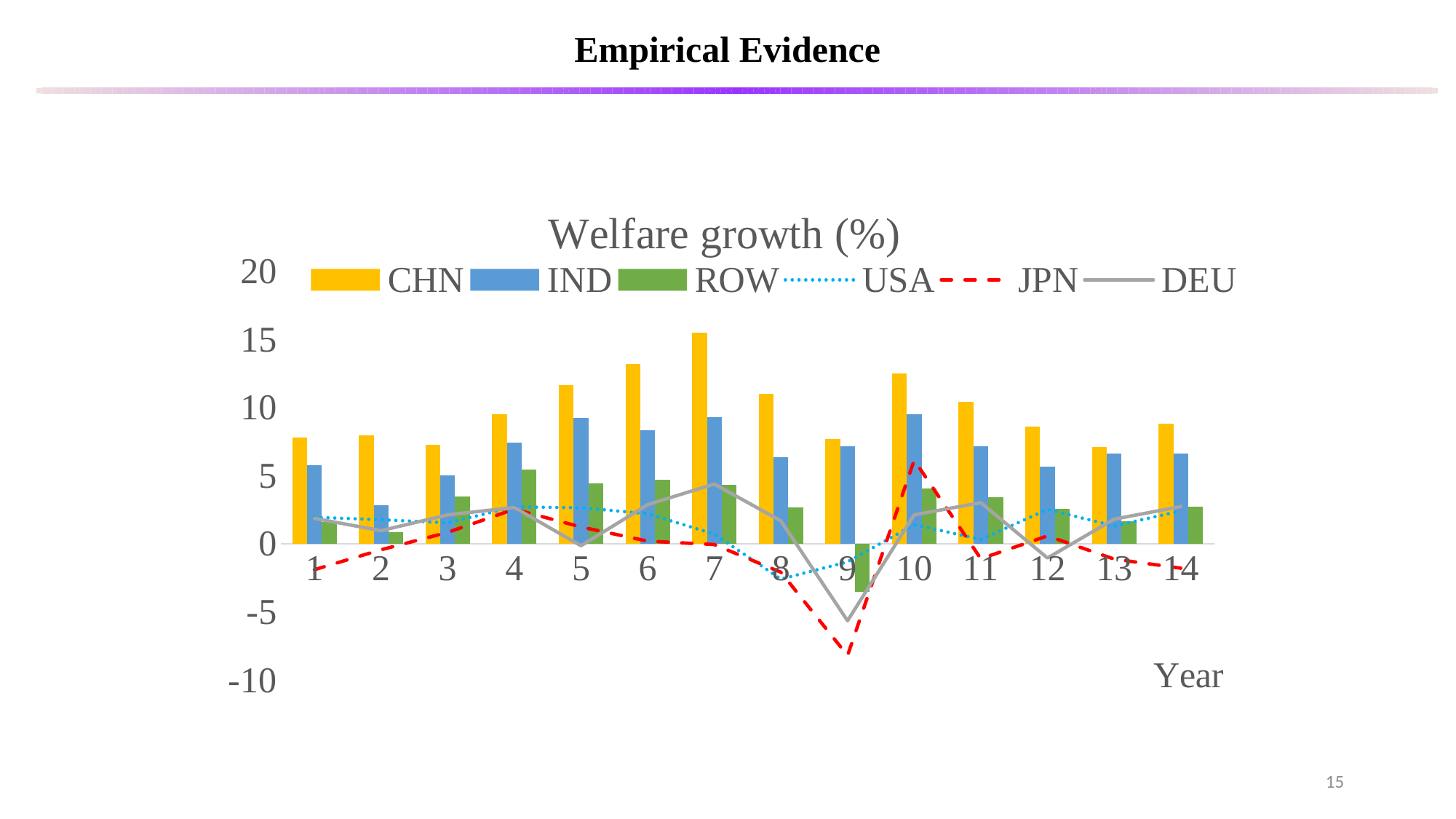
Is the ROW value in year 9 greater or less than 0? less How many series does the legend list? 6 Do the CHN bars rise or fall from year 4 to year 7? rise Which is larger in year 7, the CHN bar or the IND bar? CHN In which year is the ROW bar lowest? 9 What kind of chart is shown on the slide? A combined bar and line chart Is the CHN value in year 7 greater or less than 15? greater In which year does the JPN line reach its lowest point? 9 What is the title of the chart? Welfare growth (%) Which series are drawn as bars rather than lines? CHN, IND and ROW How many years are shown on the x axis? 14 In which year is the CHN bar highest? 7